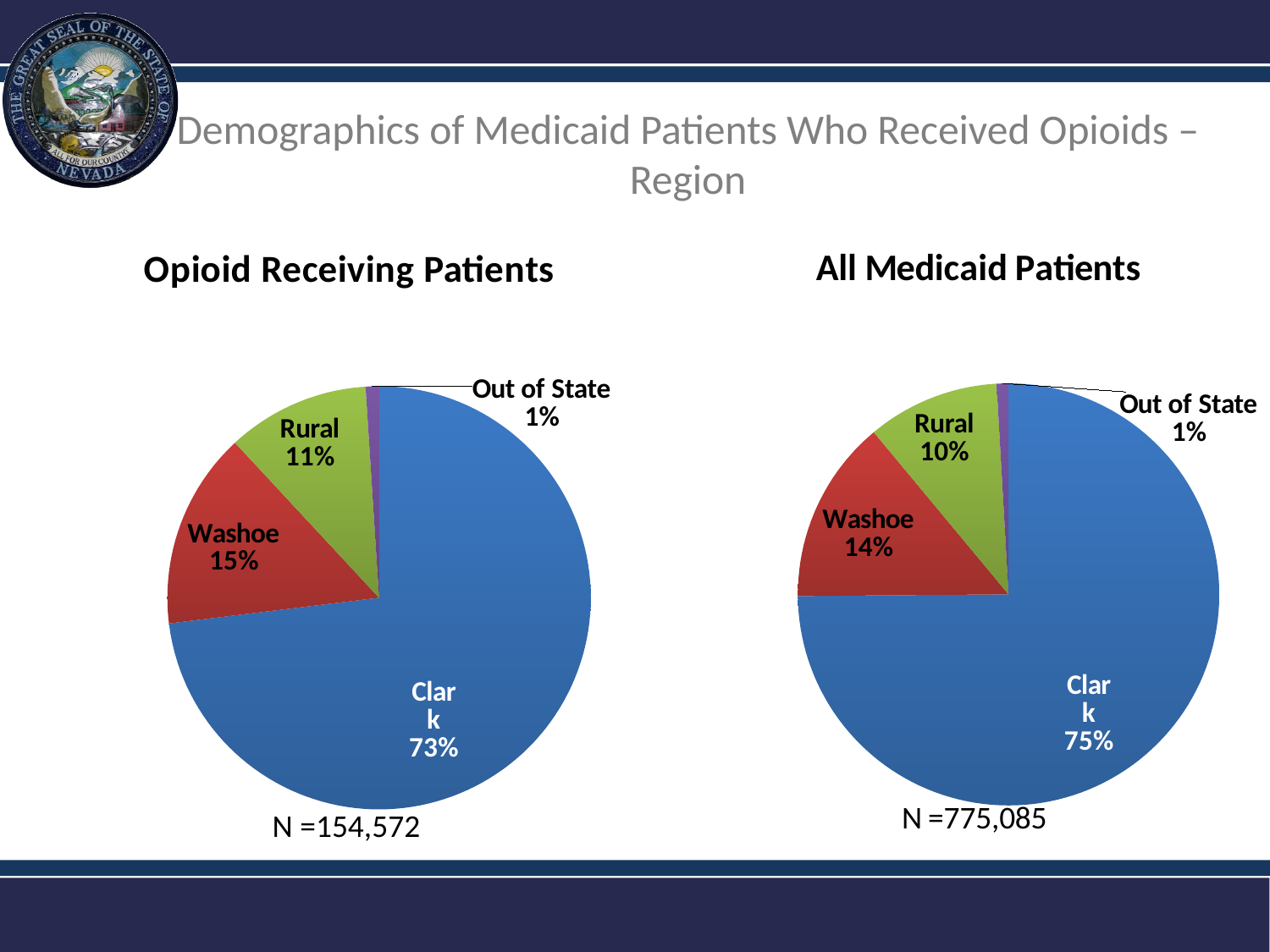
In the Opioid Receiving Patients pie chart, what is the difference between the Washoe and Rural shares? 4% In the All Medicaid Patients pie chart, what percentage is Out of State? 1% In the All Medicaid Patients pie chart, what share does Washoe have? 14% In the Opioid Receiving Patients pie chart, what share does Clark have? 73% What type of chart is used for All Medicaid Patients? Pie chart What is the N value shown under the Opioid Receiving Patients pie chart? 154,572 In the All Medicaid Patients pie chart, which is larger, Washoe or Rural? Washoe In the Opioid Receiving Patients pie chart, which region has the largest slice? Clark In the All Medicaid Patients pie chart, which region has the smallest slice? Out of State What is the N value shown under the All Medicaid Patients pie chart? 775,085 In the Opioid Receiving Patients pie chart, what percentage is Rural? 11% How many slices does the Opioid Receiving Patients pie chart have? 4